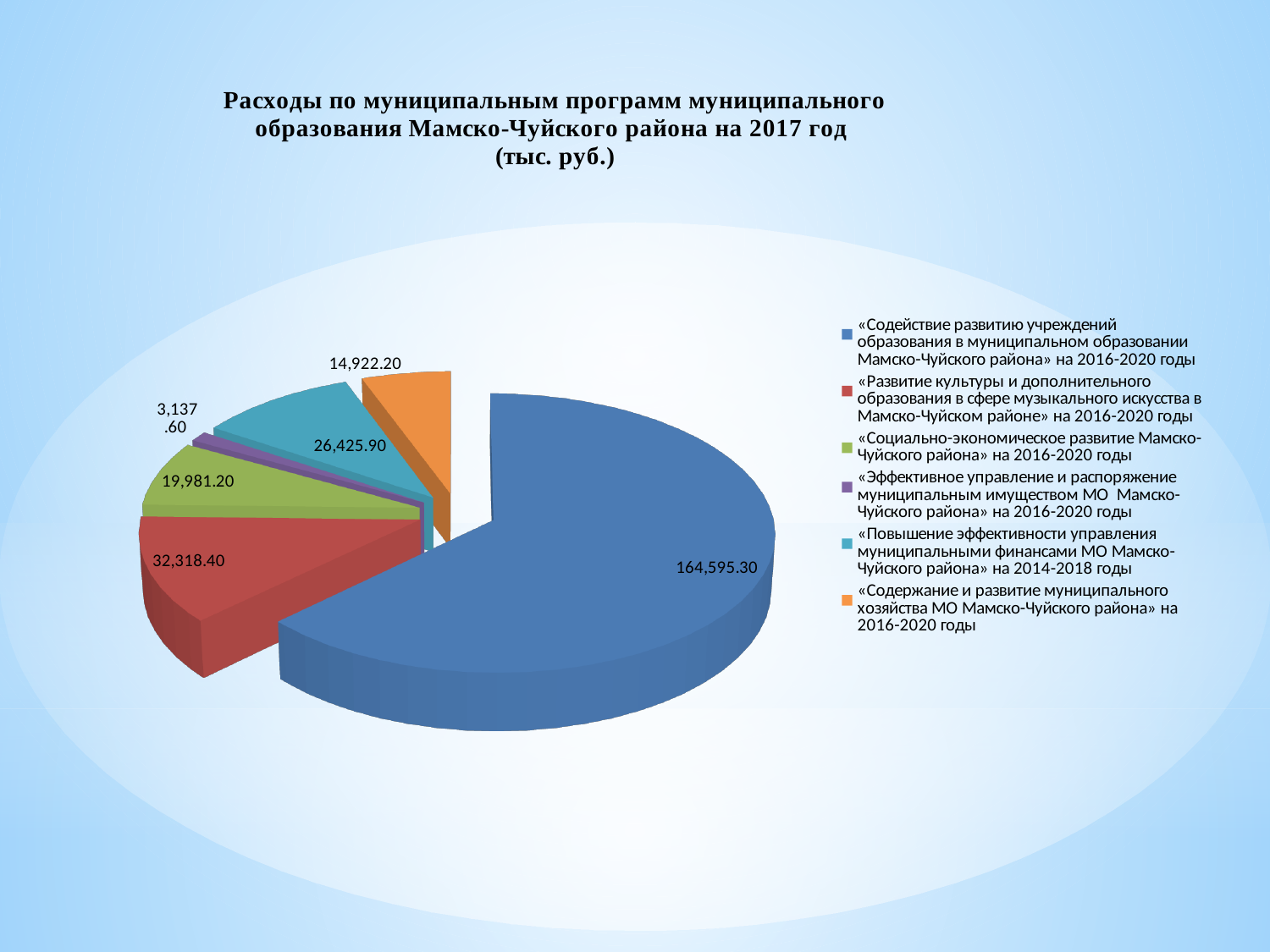
What is the value for the programme «Развитие культуры и дополнительного образования в сфере музыкального искусства в Мамско-Чуйском районе» на 2016-2020 годы? 32,318.40 What is the value for the programme «Содействие развитию учреждений образования в муниципальном образовании Мамско-Чуйского района» на 2016-2020 годы? 164,595.30 How many slices does the pie chart have? 6 Which is larger: the value for the socio-economic development programme or the municipal economy (хозяйство) programme? Socio-economic development programme (19,981.20) What is the value for the programme «Социально-экономическое развитие Мамско-Чуйского района» на 2016-2020 годы? 19,981.20 What is the difference between the value for the culture and additional education programme (32,318.40) and the municipal finances programme (26,425.90)? 5,892.50 What is the value for the programme «Содержание и развитие муниципального хозяйства МО Мамско-Чуйского района» на 2016-2020 годы? 14,922.20 What is the value for the programme «Эффективное управление и распоряжение муниципальным имуществом МО Мамско-Чуйского района» на 2016-2020 годы? 3,137.60 Which programme has the largest expenditure in the pie chart? «Содействие развитию учреждений образования в муниципальном образовании Мамско-Чуйского района» на 2016-2020 годы What is the value for the programme «Повышение эффективности управления муниципальными финансами МО Мамско-Чуйского района» на 2014-2018 годы? 26,425.90 Which programme has the smallest expenditure in the pie chart? «Эффективное управление и распоряжение муниципальным имуществом МО Мамско-Чуйского района» на 2016-2020 годы What type of chart is shown on the slide? Pie chart